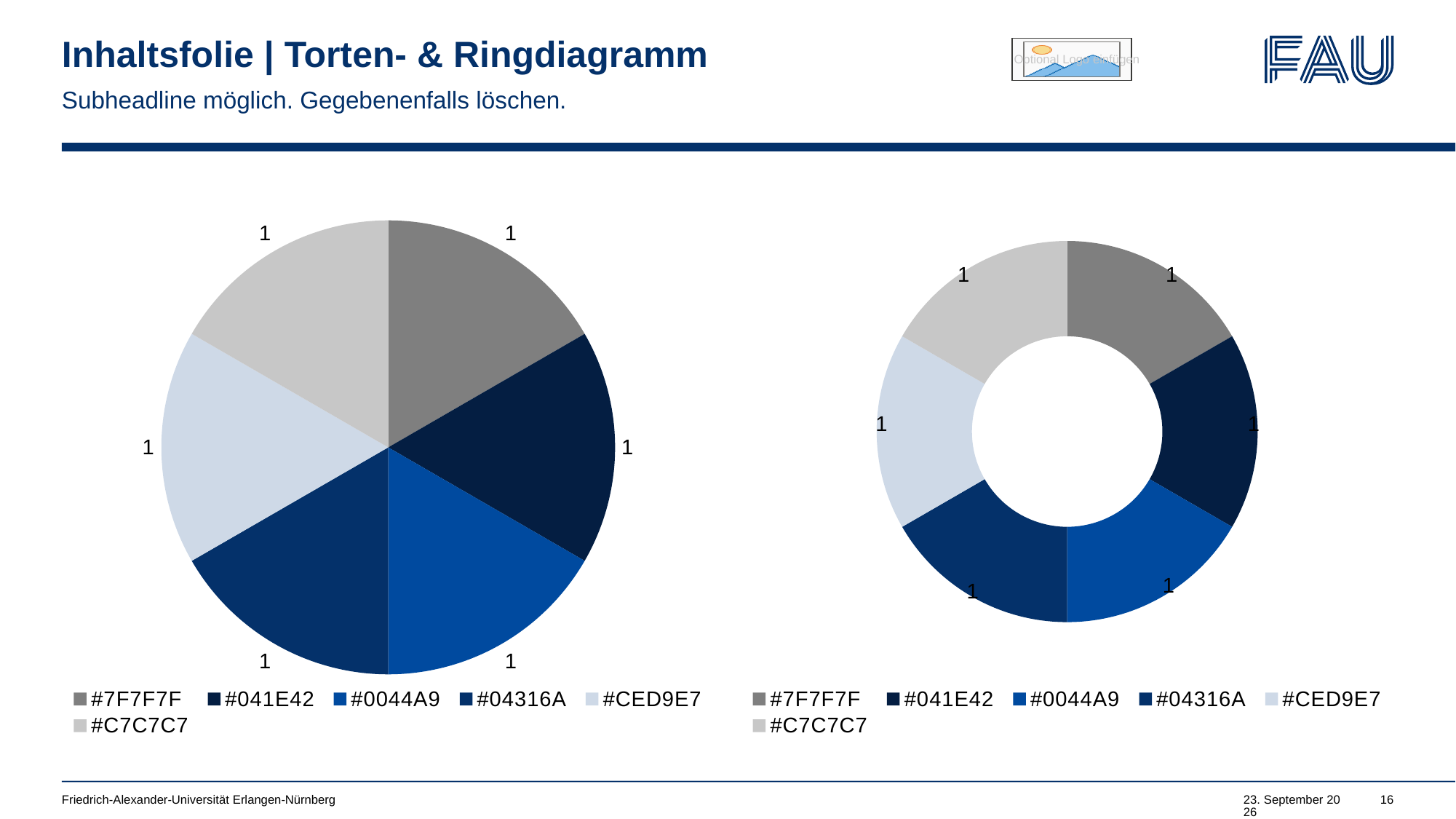
In the doughnut chart on the right, what is the value of the #CED9E7 segment? 1 What kind of chart is the chart on the right side of the slide? doughnut chart What kind of chart is the chart on the left side of the slide? pie chart In the doughnut chart on the right, what is the total of all segment values? 6 In the pie chart on the left, what is the total of all slice values? 6 Which legend entry in the doughnut chart on the right is listed first? #7F7F7F In the pie chart on the left, how many slices are there? 6 In the pie chart on the left, what is the value of the #0044A9 slice? 1 In the doughnut chart on the right, how many segments are there? 6 In the pie chart on the left, what is the difference between the values of the #7F7F7F and #C7C7C7 slices? 0 How many entries does the legend of the pie chart on the left list? 6 Which legend entry in the pie chart on the left is listed last? #C7C7C7